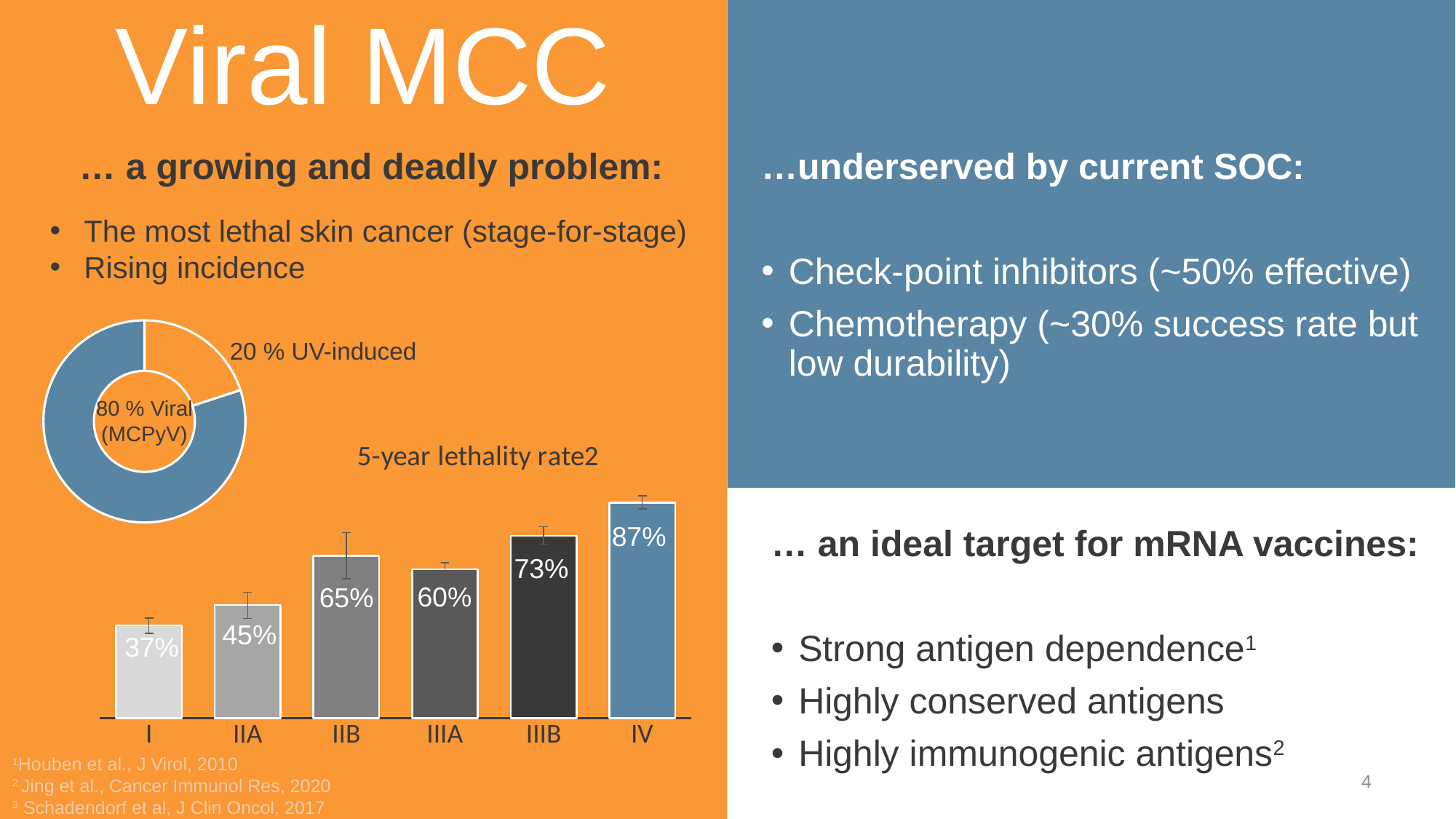
In the 5-year lethality rate bar chart, what is the value for stage IIA? 45% In the 5-year lethality rate bar chart, which stage has the lowest lethality rate? I What kind of chart is the 5-year lethality rate chart? Bar chart In the 5-year lethality rate bar chart, which is larger, the value for stage IIB or stage IIIA? IIB In the 5-year lethality rate bar chart, which stage has the highest lethality rate? IV In the donut chart on the left, what share of MCC is UV-induced? 20 % What is the title of the bar chart on the slide? 5-year lethality rate2 In the 5-year lethality rate bar chart, what is the value for stage IV? 87% In the 5-year lethality rate bar chart, what is the difference between the values for stage IV and stage I? 50% In the 5-year lethality rate bar chart, what is the value for stage IIIA? 60% In the donut chart on the left, what share of MCC is viral (MCPyV)? 80 % How many stages are shown in the 5-year lethality rate bar chart? 6